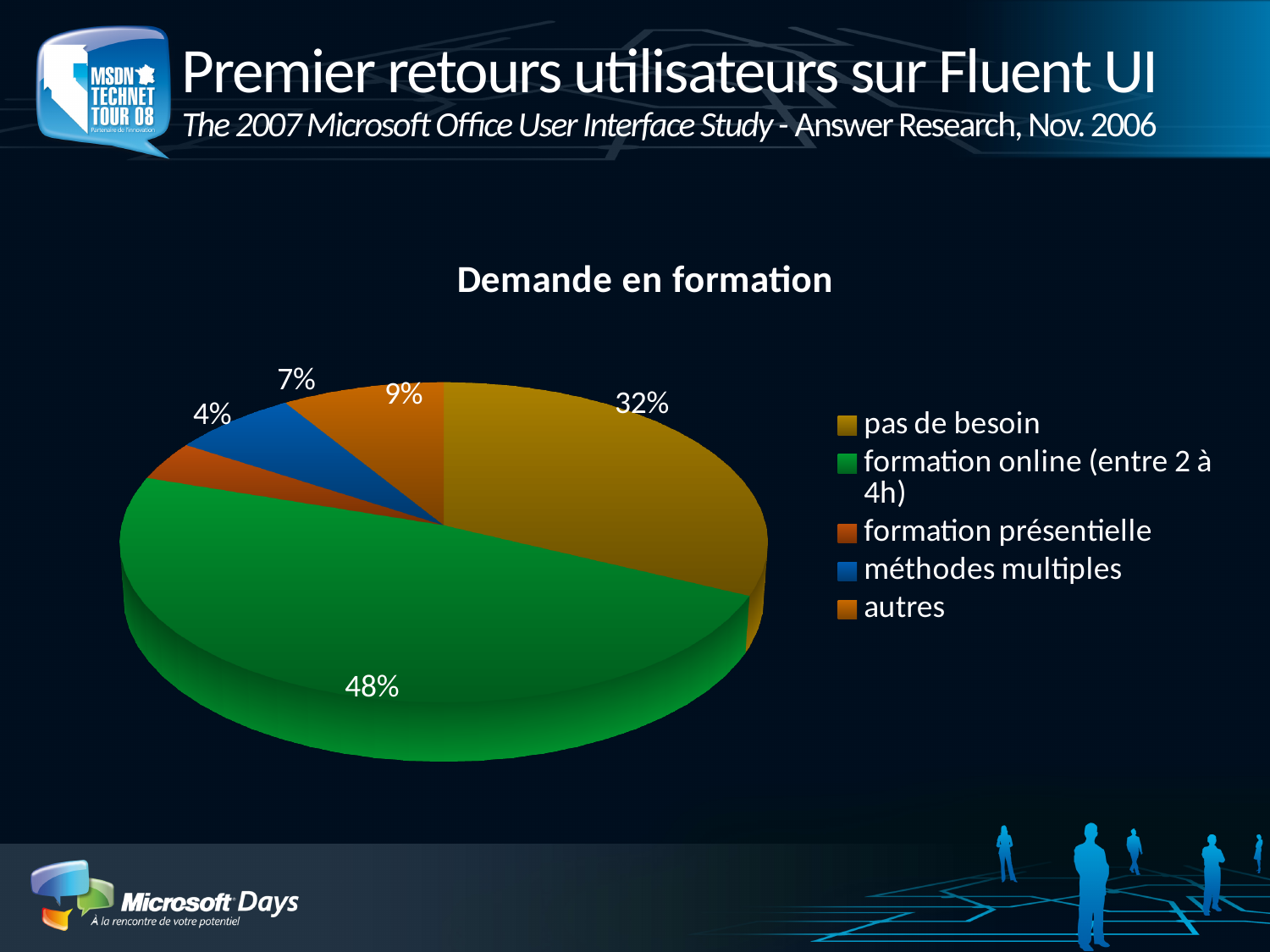
Which category has the smallest slice of the pie? formation présentielle What share of the pie is 'pas de besoin'? 32% What is the title of the chart? Demande en formation How many slices does the pie chart have? 5 What share of the pie is 'méthodes multiples'? 7% What is the difference between the shares of 'formation online (entre 2 à 4h)' and 'pas de besoin'? 16% What share of the pie is 'autres'? 9% What kind of chart is shown on the slide? pie chart Which is larger, the share for 'autres' or the share for 'méthodes multiples'? autres Which category has the largest slice of the pie? formation online (entre 2 à 4h)